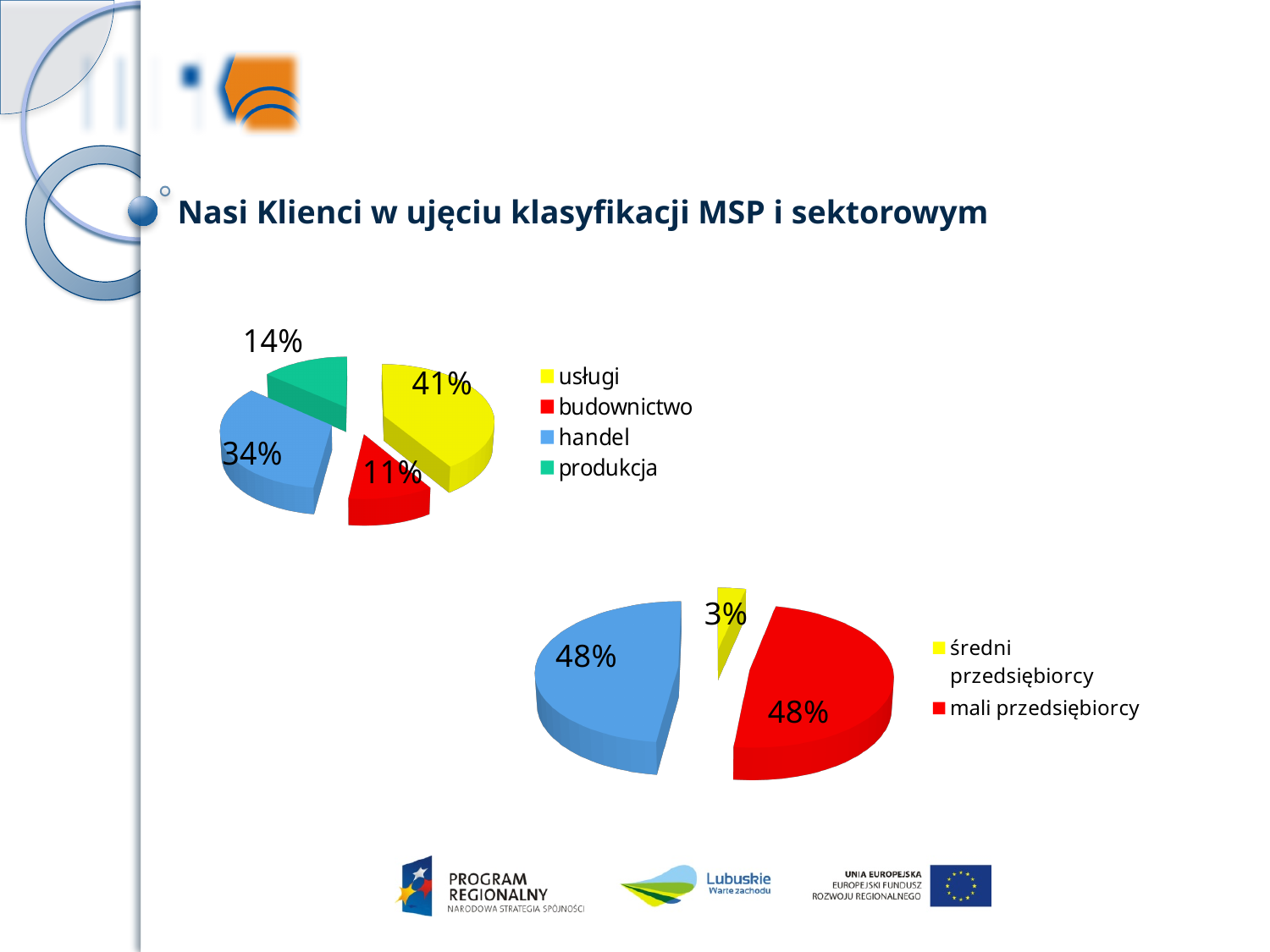
In the upper pie chart, which category has the largest share? usługi What type of chart is the lower chart on the slide? pie chart In the upper pie chart, what share is labelled for usługi? 41% How many categories does the legend of the upper pie chart list? 4 In the lower pie chart, what share is labelled for średni przedsiębiorcy? 3% In the upper pie chart, which category has the smallest share? budownictwo In the upper pie chart, what is the difference in percentage points between usługi and handel? 7 In the lower pie chart, what share is labelled for mali przedsiębiorcy? 48% In the upper pie chart, which is larger, produkcja or budownictwo? produkcja In the upper pie chart, what share is labelled for produkcja? 14% In the upper pie chart, what share is labelled for handel? 34% In the upper pie chart, what share is labelled for budownictwo? 11%